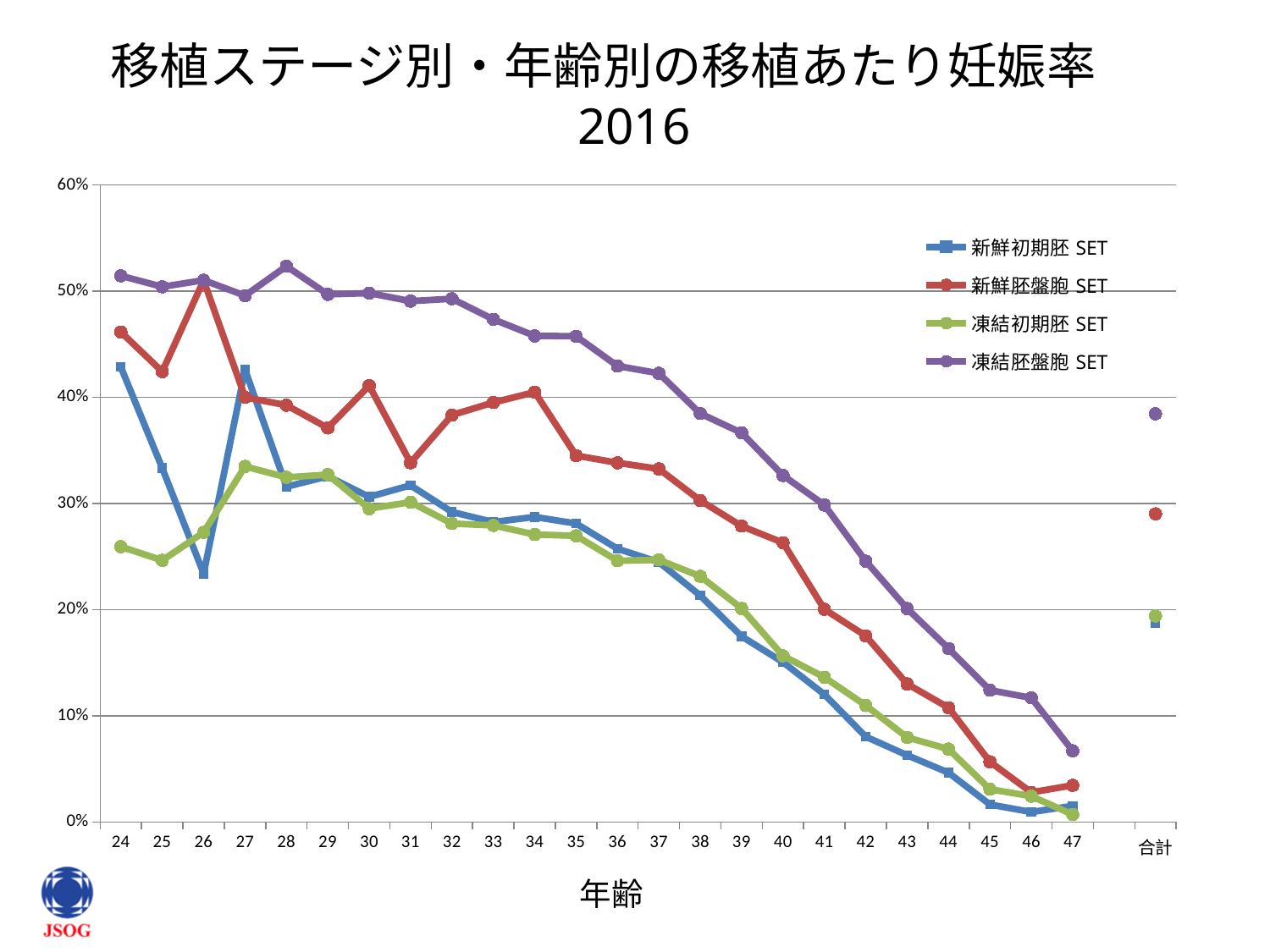
At age 26, which is higher: 新鮮初期胚 SET or 凍結初期胚 SET? 凍結初期胚 SET Is the value for 凍結初期胚 SET at age 24 greater or less than 20%? greater Which series has the highest value at age 35? 凍結胚盤胞 SET How many age categories (excluding 合計) are shown on the x axis? 24 Is the value for 凍結胚盤胞 SET at age 47 greater or less than 10%? less How many series does the legend list? 4 Is the value for 新鮮胚盤胞 SET at age 26 greater or less than 40%? greater What kind of chart is shown on the slide? line chart Which series has the lowest value at age 24? 凍結初期胚 SET At age 30, which is higher: 新鮮胚盤胞 SET or 凍結胚盤胞 SET? 凍結胚盤胞 SET Does the 凍結胚盤胞 SET series generally rise or fall as age increases from 24 to 47? fall What is the label of the x axis? 年齢